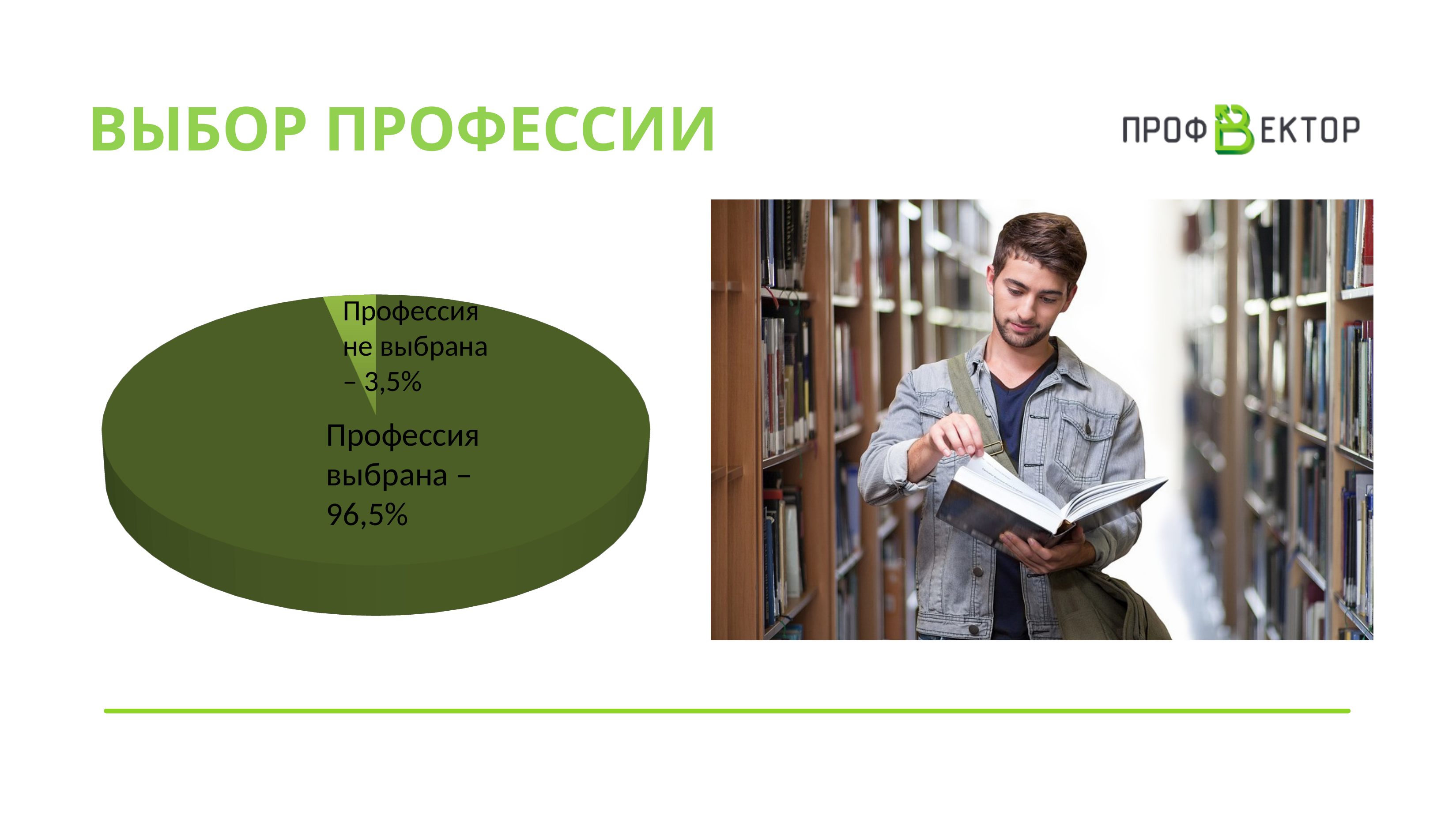
Which slice of the pie is the smallest? Профессия не выбрана How many slices does the pie chart have? 2 Which slice of the pie is the largest? Профессия выбрана What share of the pie is labelled "Профессия не выбрана"? 3,5% What share of the pie is labelled "Профессия выбрана"? 96,5% What colour is the "Профессия не выбрана" slice compared with the rest of the pie? lighter green What is the title of the slide containing the pie chart? ВЫБОР ПРОФЕССИИ Which is larger: the share for "Профессия выбрана" or for "Профессия не выбрана"? Профессия выбрана What is the difference in percentage points between "Профессия выбрана" and "Профессия не выбрана"? 93 percentage points What kind of chart is shown on the slide? pie chart